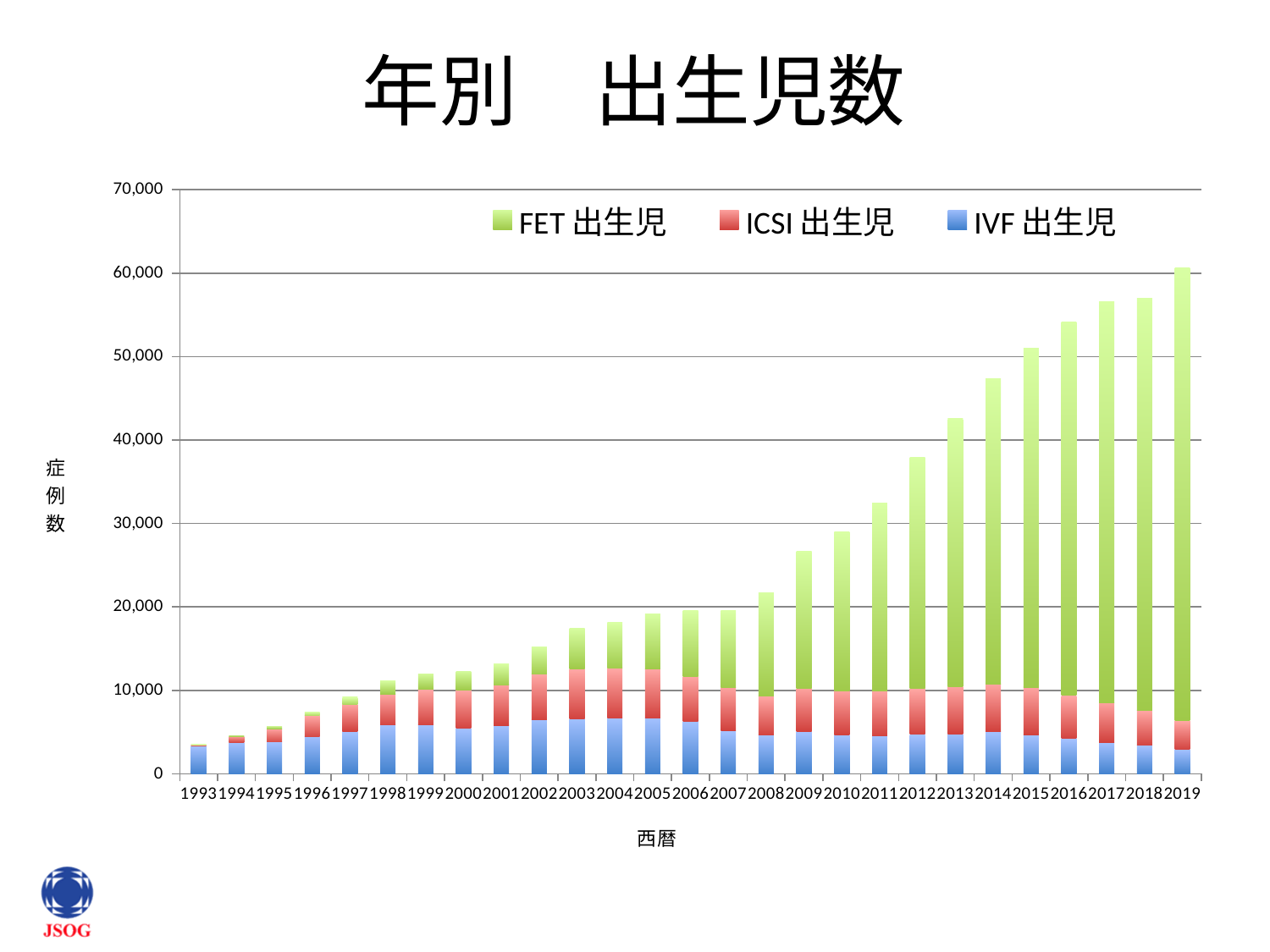
Is the total value for 2012 greater or less than 40,000? less How many series does the legend list? 3 Which year has the highest total number of births? 2019 Which series is shown in green in the legend? FET 出生児 Do the total bar heights generally rise or fall from 1993 to 2019? Rise Is the total value for 2016 greater or less than 50,000? greater Is the total value for 2013 greater or less than 40,000? greater Which year has the larger total, 2009 or 2010? 2010 What is the title of the chart? 年別 出生児数 What kind of chart is shown on the slide? Stacked bar chart How many years are shown along the x axis? 27 Which year has the lowest total number of births? 1993